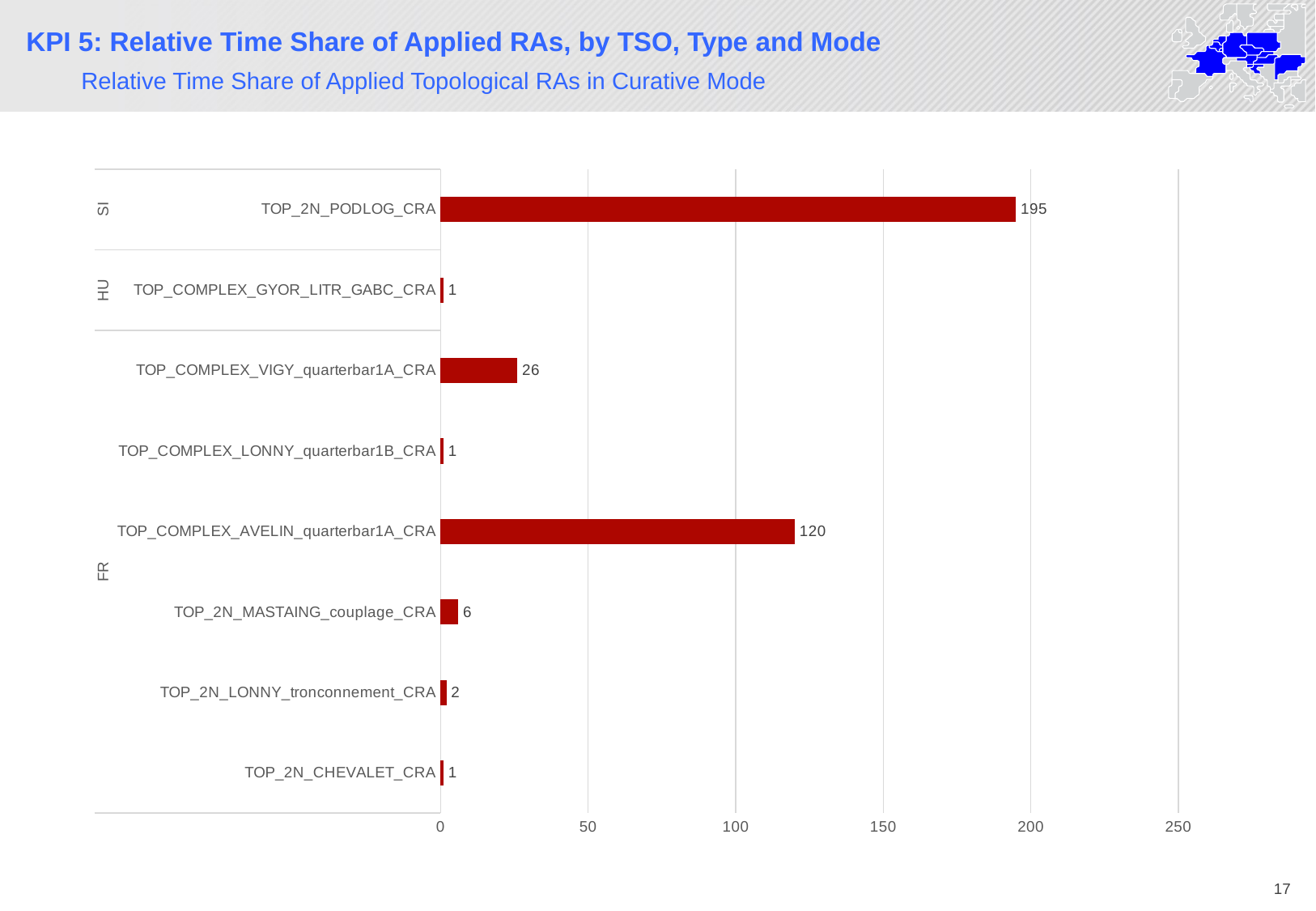
Which is larger, the value for TOP_COMPLEX_VIGY_quarterbar1A_CRA or TOP_2N_MASTAING_couplage_CRA? TOP_COMPLEX_VIGY_quarterbar1A_CRA What is the value for TOP_2N_PODLOG_CRA? 195 How many categories are shown in the chart? 8 What is the value for TOP_2N_LONNY_tronconnement_CRA? 2 What is the value for TOP_COMPLEX_VIGY_quarterbar1A_CRA? 26 What is the value for TOP_2N_MASTAING_couplage_CRA? 6 Which category has the highest value? TOP_2N_PODLOG_CRA Is the value for TOP_COMPLEX_AVELIN_quarterbar1A_CRA greater or less than 100? greater Which TSO group contains the category TOP_COMPLEX_GYOR_LITR_GABC_CRA? HU What kind of chart is shown on the slide? bar chart What is the difference between the values for TOP_2N_PODLOG_CRA and TOP_COMPLEX_AVELIN_quarterbar1A_CRA? 75 What is the value for TOP_COMPLEX_AVELIN_quarterbar1A_CRA? 120